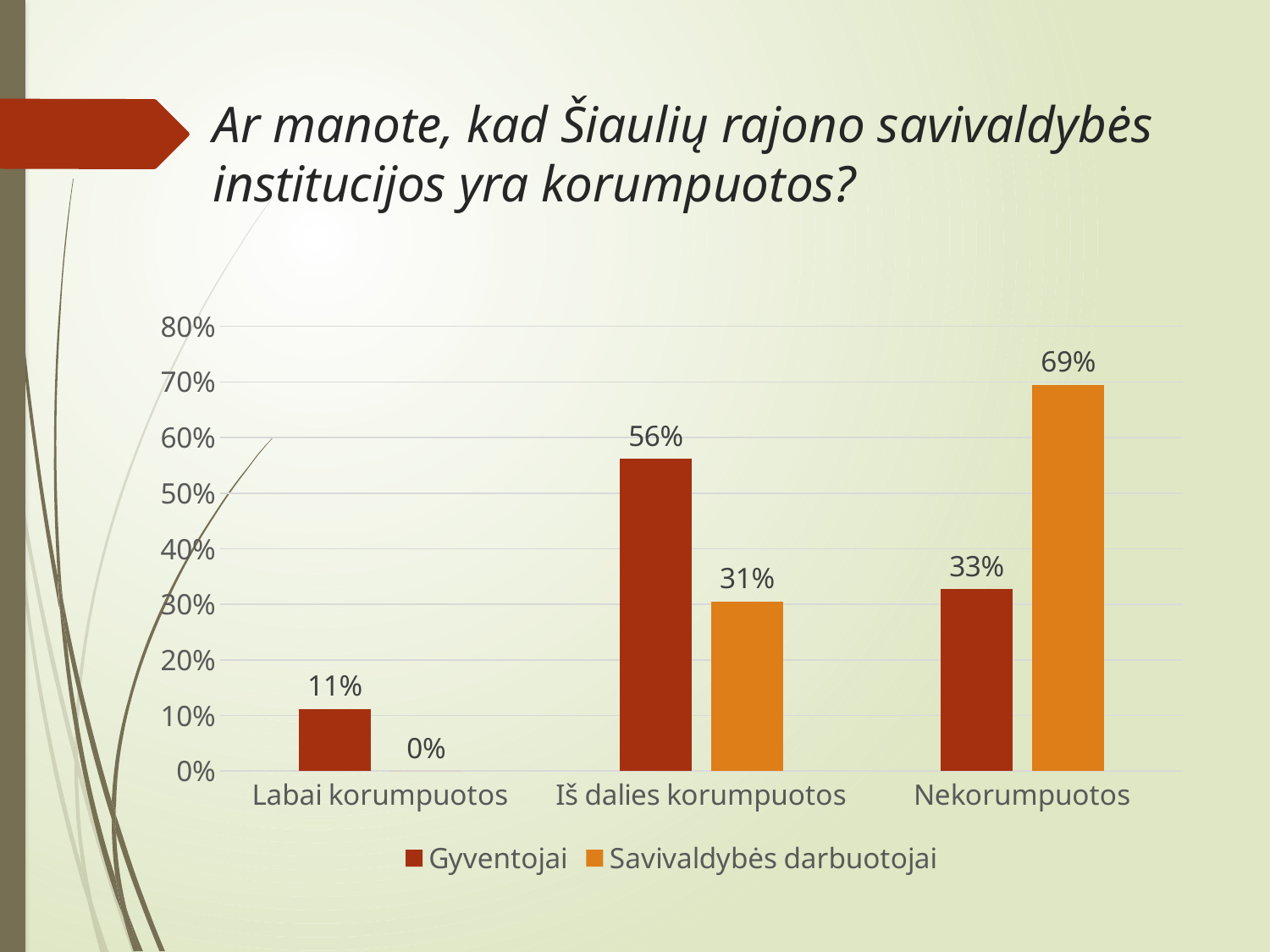
How many series does the legend list? 2 What is the value for Savivaldybės darbuotojai in the Nekorumpuotos category? 69% How many categories are shown on the x axis? 3 What kind of chart is shown on the slide? bar chart Which category has the lowest value for Savivaldybės darbuotojai? Labai korumpuotos Which category has the highest value for Gyventojai? Iš dalies korumpuotos What is the difference between Gyventojai and Savivaldybės darbuotojai in the Iš dalies korumpuotos category? 25% What colour are the bars for the Savivaldybės darbuotojai series? orange What is the value for Savivaldybės darbuotojai in the Labai korumpuotos category? 0% What is the value for Gyventojai in the Labai korumpuotos category? 11% In the Nekorumpuotos category, which series has the larger value, Gyventojai or Savivaldybės darbuotojai? Savivaldybės darbuotojai What is the value for Gyventojai in the Iš dalies korumpuotos category? 56%